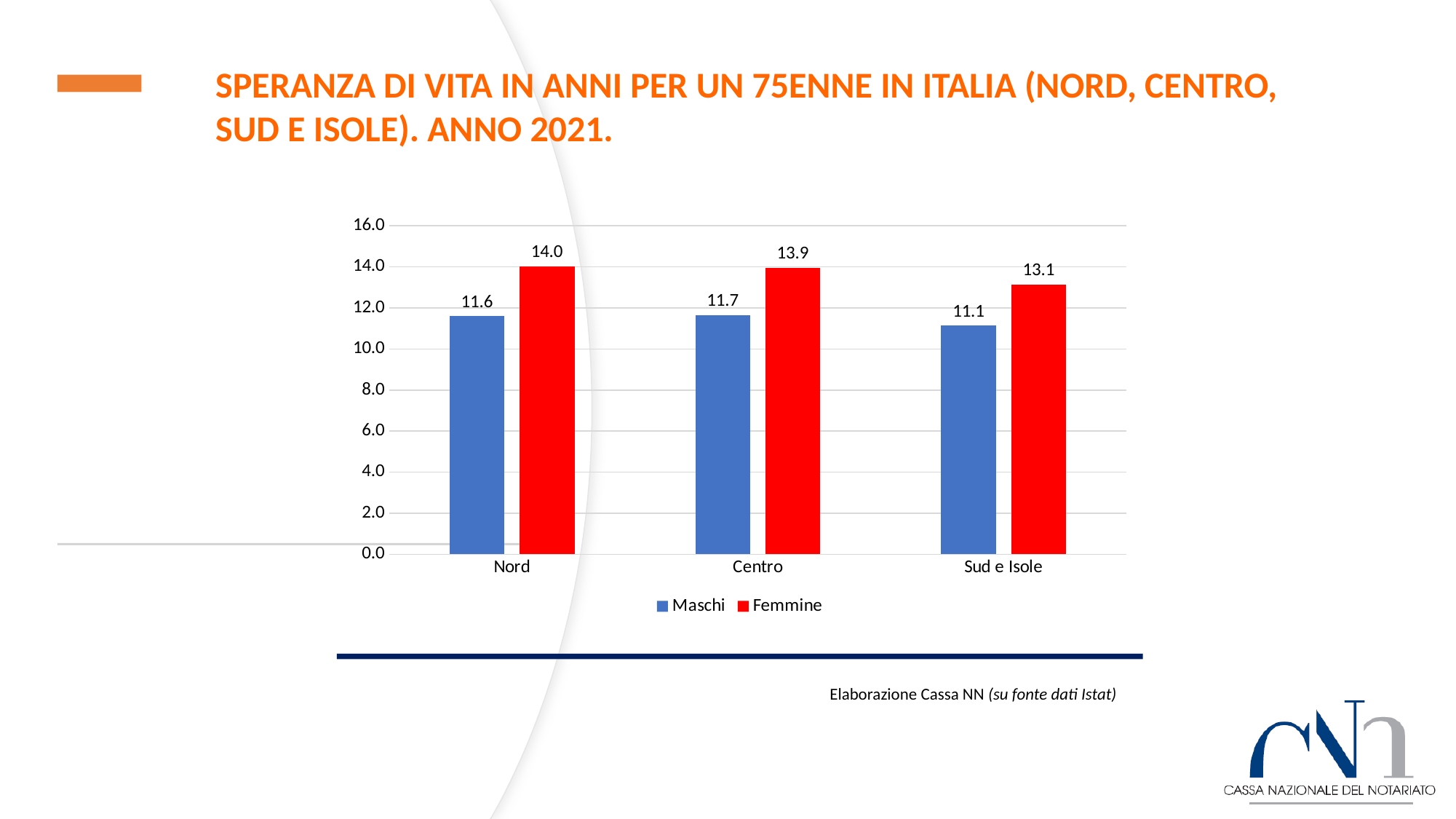
What is the difference between the Femmine and Maschi values in Nord? 2.4 Which region has the highest value for Femmine? Nord How many regions are shown on the x axis? 3 What kind of chart is shown on the slide? Bar chart Which region has the lowest value for Maschi? Sud e Isole What is the value for Femmine in Sud e Isole? 13.1 What is the value for Maschi in Nord? 11.6 Which is larger, the Maschi value in Centro or the Maschi value in Sud e Isole? Centro What is the value for Femmine in Centro? 13.9 What is the difference between the Femmine values for Centro and Sud e Isole? 0.8 Is the value for Femmine in Sud e Isole greater or less than 12.0? greater How many series does the legend list? 2